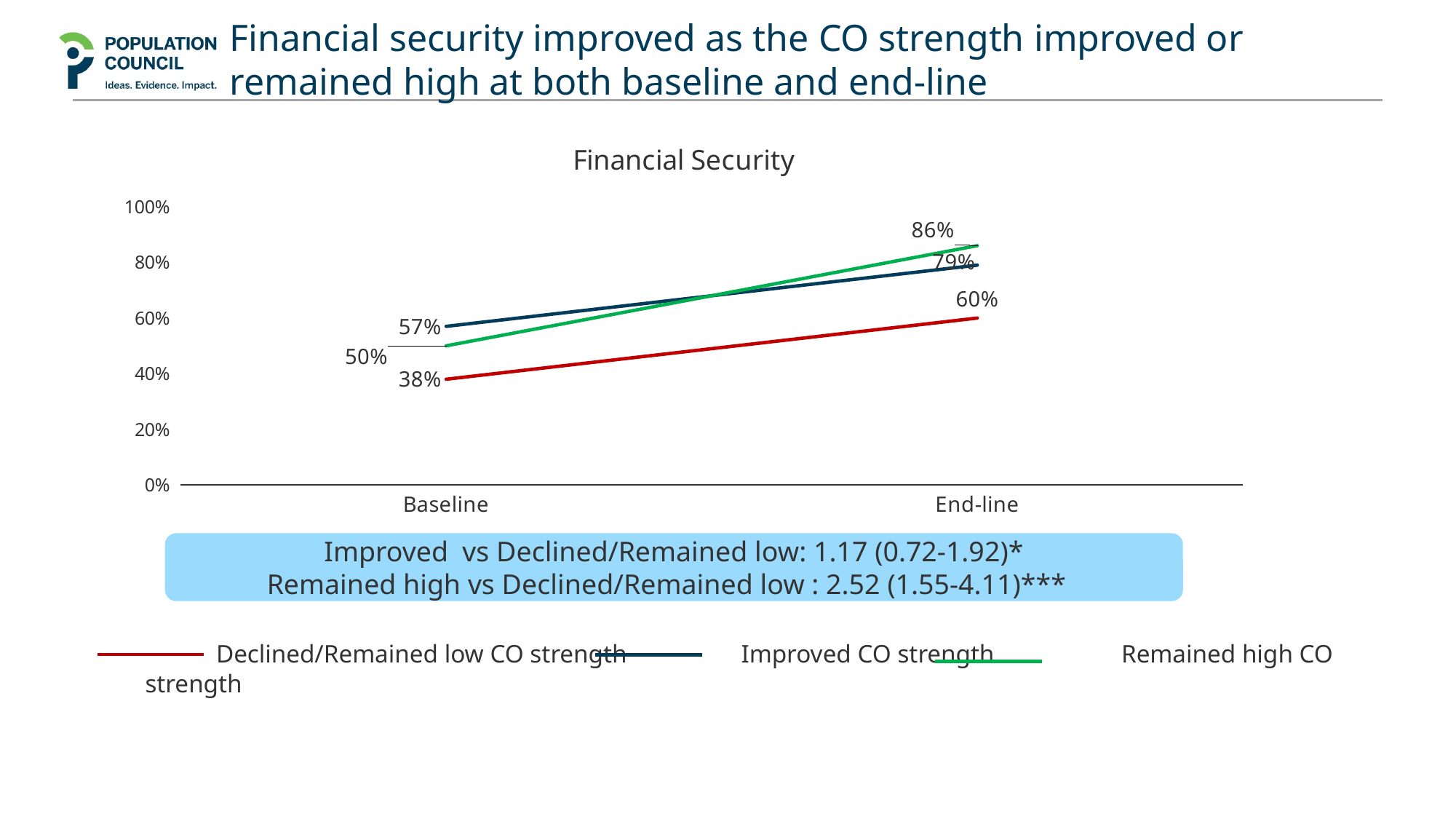
What is the Baseline value for Declined/Remained low CO strength? 38% Which series has the lowest value at Baseline? Declined/Remained low CO strength What is the Baseline value for Improved CO strength? 57% What kind of chart is shown on the slide? Line chart What is the title of the chart? Financial Security How many series does the legend list? 3 What is the End-line value for Improved CO strength? 79% At Baseline, which is larger: Improved CO strength or Remained high CO strength? Improved CO strength Which series has the highest value at End-line? Remained high CO strength Does the Declined/Remained low CO strength line rise or fall from Baseline to End-line? Rise By how many percentage points did Remained high CO strength increase from Baseline to End-line? 36 percentage points What is the End-line value for Remained high CO strength? 86%